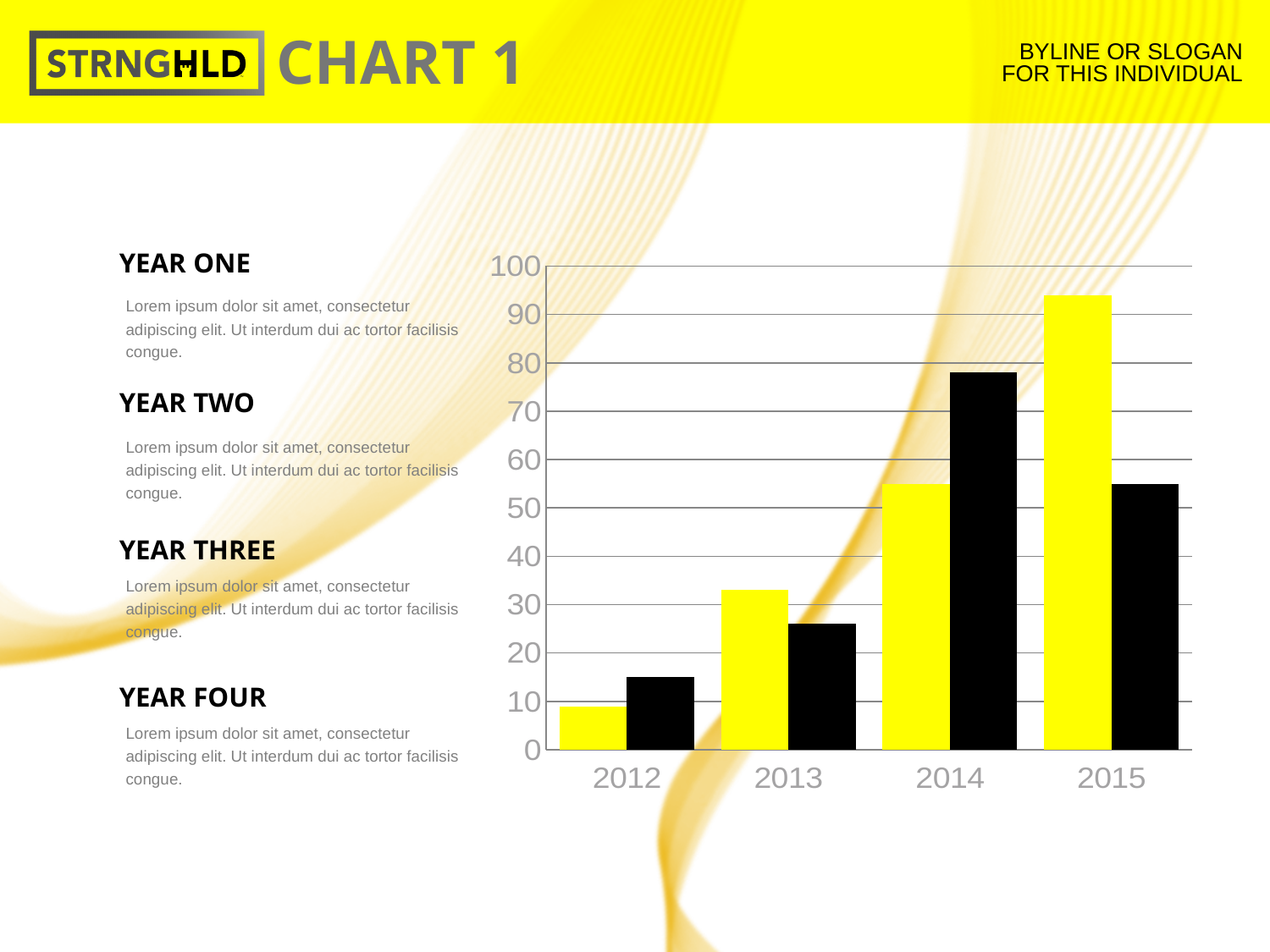
Which year has the tallest black bar? 2014 What kind of chart is shown on the slide? bar chart How many years are shown along the x axis of the chart? 4 In 2014, which bar is taller, the yellow bar or the black bar? black Is the black bar for 2014 greater or less than 70? greater Do the yellow bars rise or fall from 2012 to 2015? rise How many bars are plotted for each year in the chart? 2 Which year has the shortest yellow bar? 2012 Which year has the tallest yellow bar? 2015 Which year has the shortest black bar? 2012 Is the yellow bar for 2015 greater or less than 90? greater